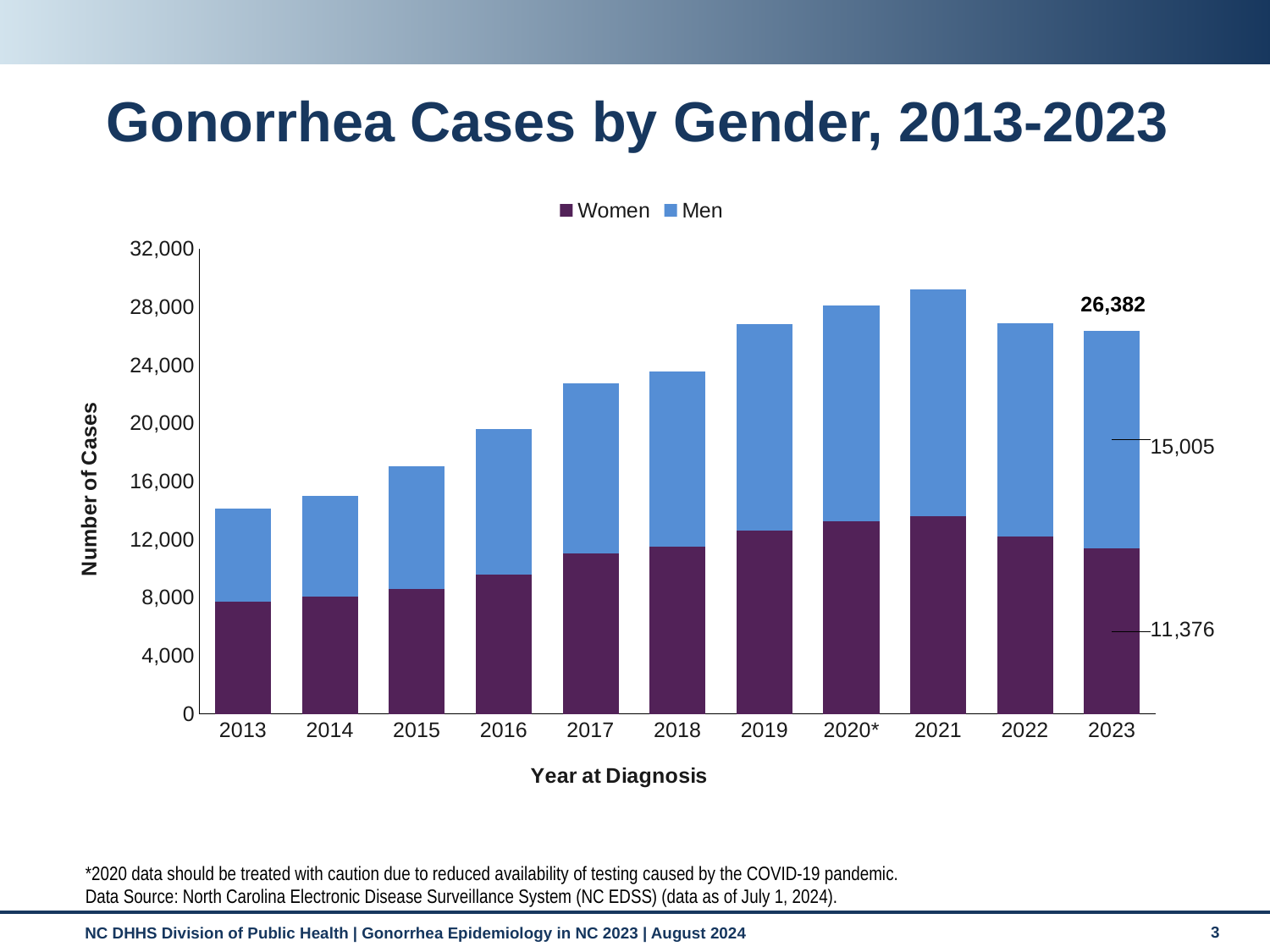
Which year has the highest total number of gonorrhea cases? 2021 What is the total number of gonorrhea cases shown for 2023? 26,382 How many gonorrhea cases among men were reported in 2023? 15,005 In 2023, which group had more cases, women or men? Men What kind of chart is used to show gonorrhea cases by gender? Stacked bar chart How many gonorrhea cases among women were reported in 2023? 11,376 In 2023, how many more cases were reported among men than among women? 3,629 How many years are shown on the x axis of the chart? 11 How many series does the legend list? 2 Which year has the lowest total number of gonorrhea cases? 2013 Is the total number of cases in 2013 greater or less than 16,000? less Do total gonorrhea cases rise or fall from 2013 to 2021? rise